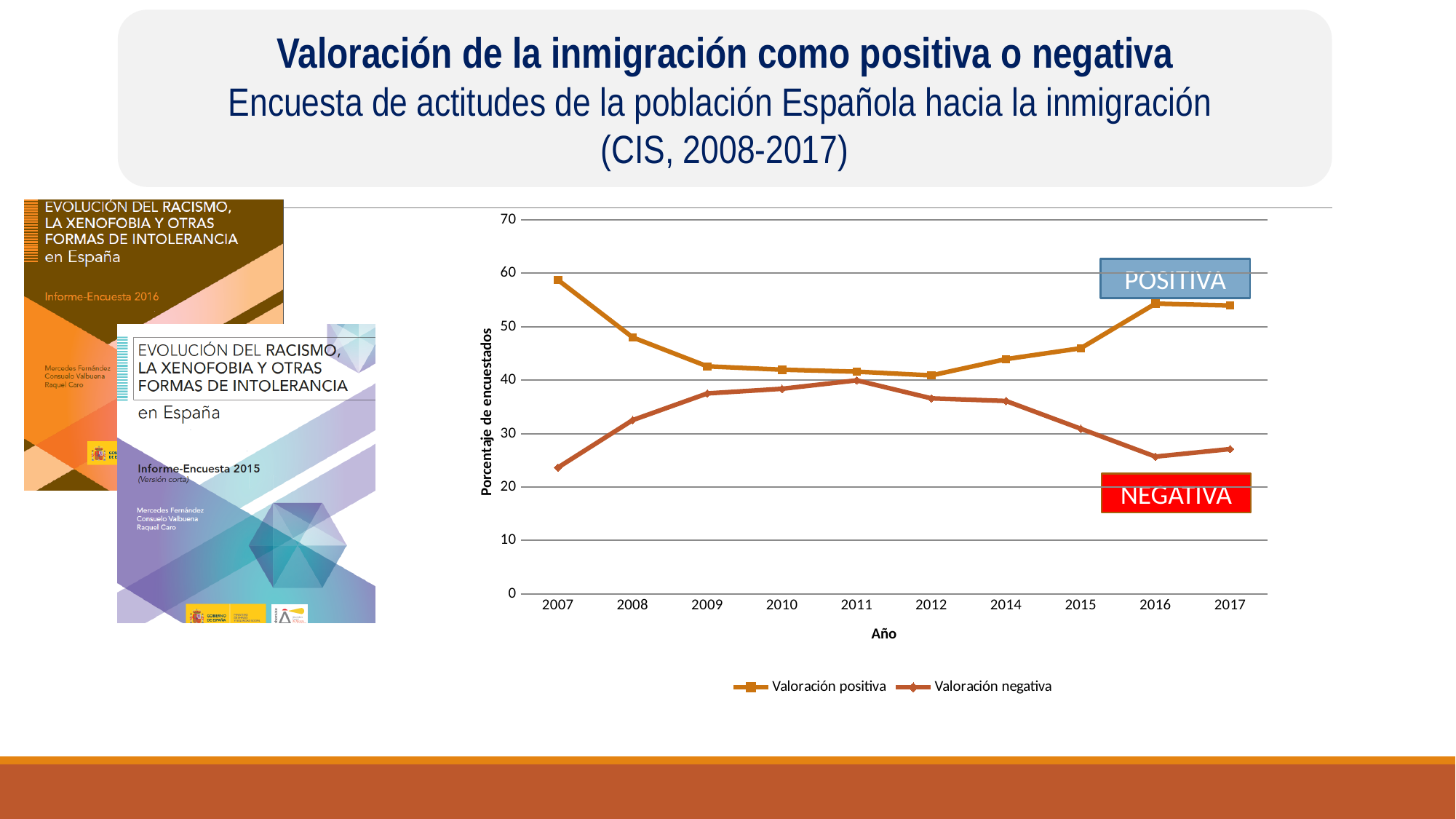
What kind of chart is shown on the slide? Line chart How many years are plotted along the x axis of the chart? 10 Is the value for Valoración negativa in 2007 greater or less than 30? less Does the Valoración positiva series rise or fall from 2007 to 2012? Fall Does the Valoración negativa series rise or fall from 2007 to 2011? Rise How many series does the chart legend list? 2 What is the title of the chart's y axis? Porcentaje de encuestados Is the value for Valoración negativa in 2016 greater or less than 30? less Is the value for Valoración positiva in 2016 greater or less than 50? greater In 2017, which series has the larger value, Valoración positiva or Valoración negativa? Valoración positiva